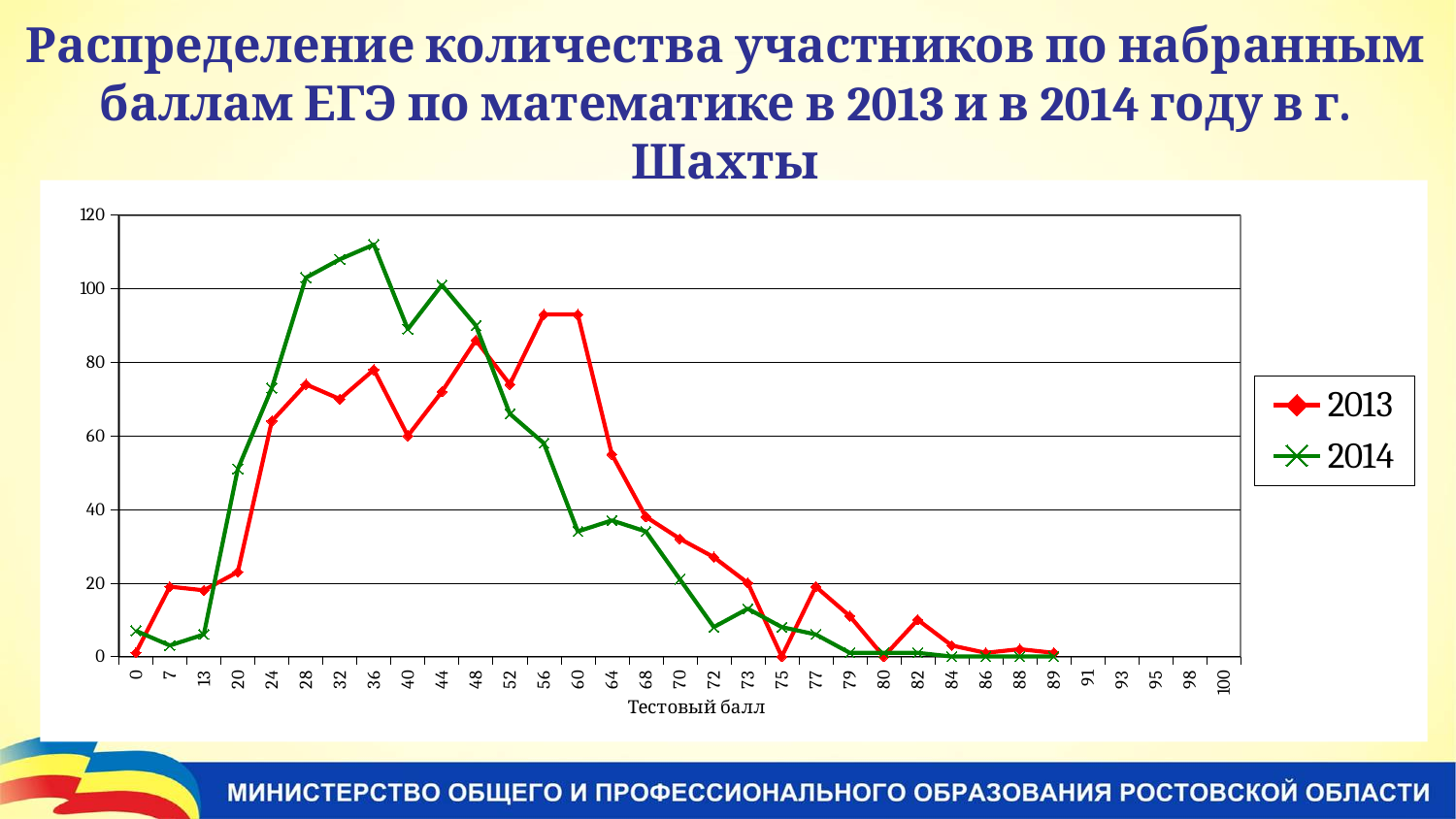
Is the value for 2014 at score 36 greater or less than 100? greater At score 20, which series has the larger value, 2013 or 2014? 2014 What kind of chart is shown on the slide? line chart How many series does the legend list? 2 Is the value for 2014 at score 0 greater or less than 20? less How many score categories are shown along the x axis? 33 Is the value for 2013 at score 56 greater or less than 80? greater At score 36, which series has the larger value, 2013 or 2014? 2014 At score 56, which series has the larger value, 2013 or 2014? 2013 What is the title of the x axis? Тестовый балл At which test score does the 2014 series reach its highest value? 36